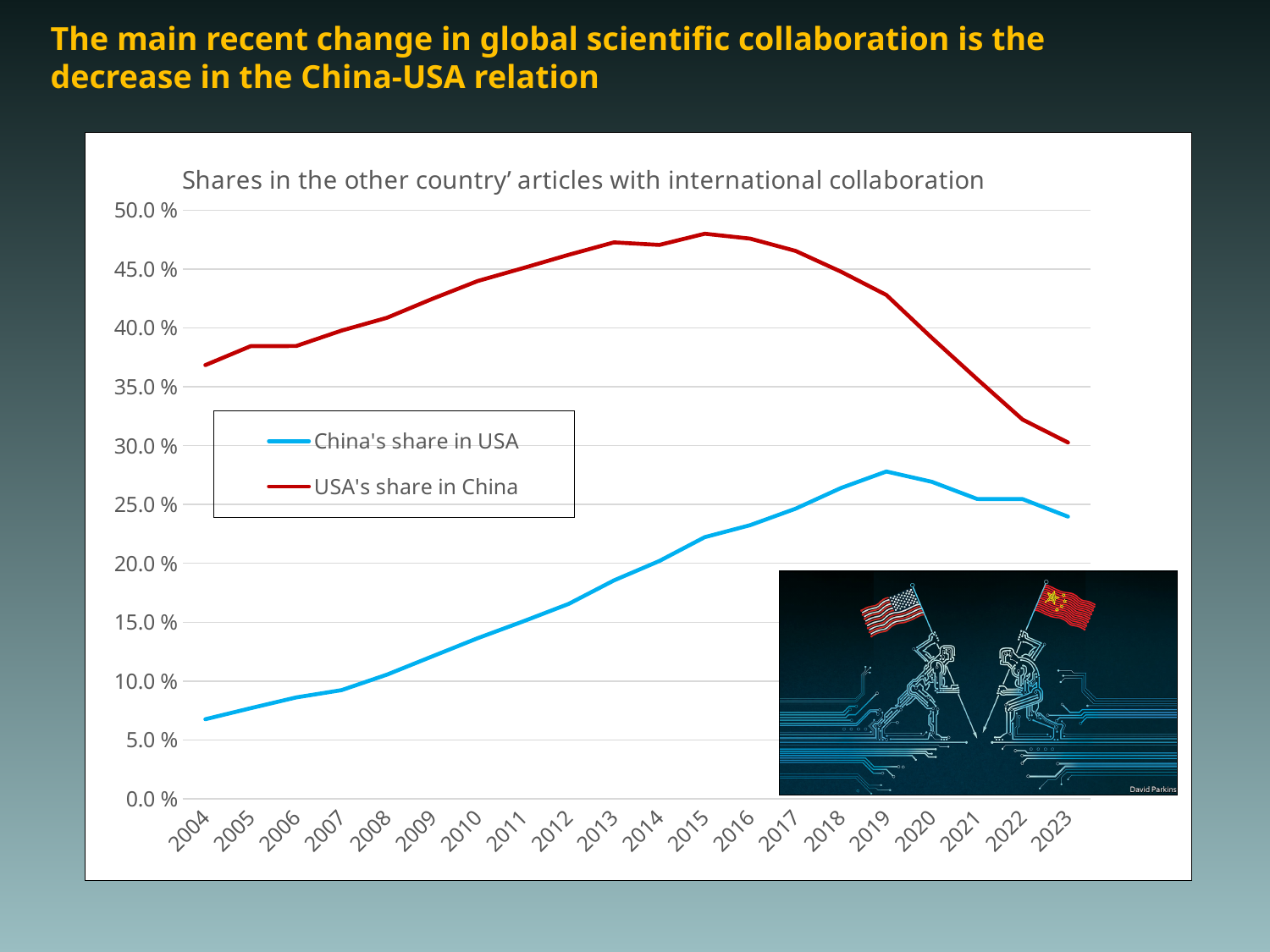
In which year is USA's share in China at its highest? 2015 Is the value for USA's share in China in 2023 greater or less than 35.0 %? less In 2023, which is larger: China's share in USA or USA's share in China? USA's share in China In which year is China's share in USA at its highest? 2019 Does USA's share in China rise or fall from 2015 to 2023? Fall In which year is China's share in USA at its lowest? 2004 Is the value for China's share in USA in 2004 greater or less than 10.0 %? less Which series is drawn in red? USA's share in China What kind of chart is shown on the slide? Line chart How many series does the legend list? 2 What is the title of the chart? Shares in the other country' articles with international collaboration How many years are plotted along the x axis? 20